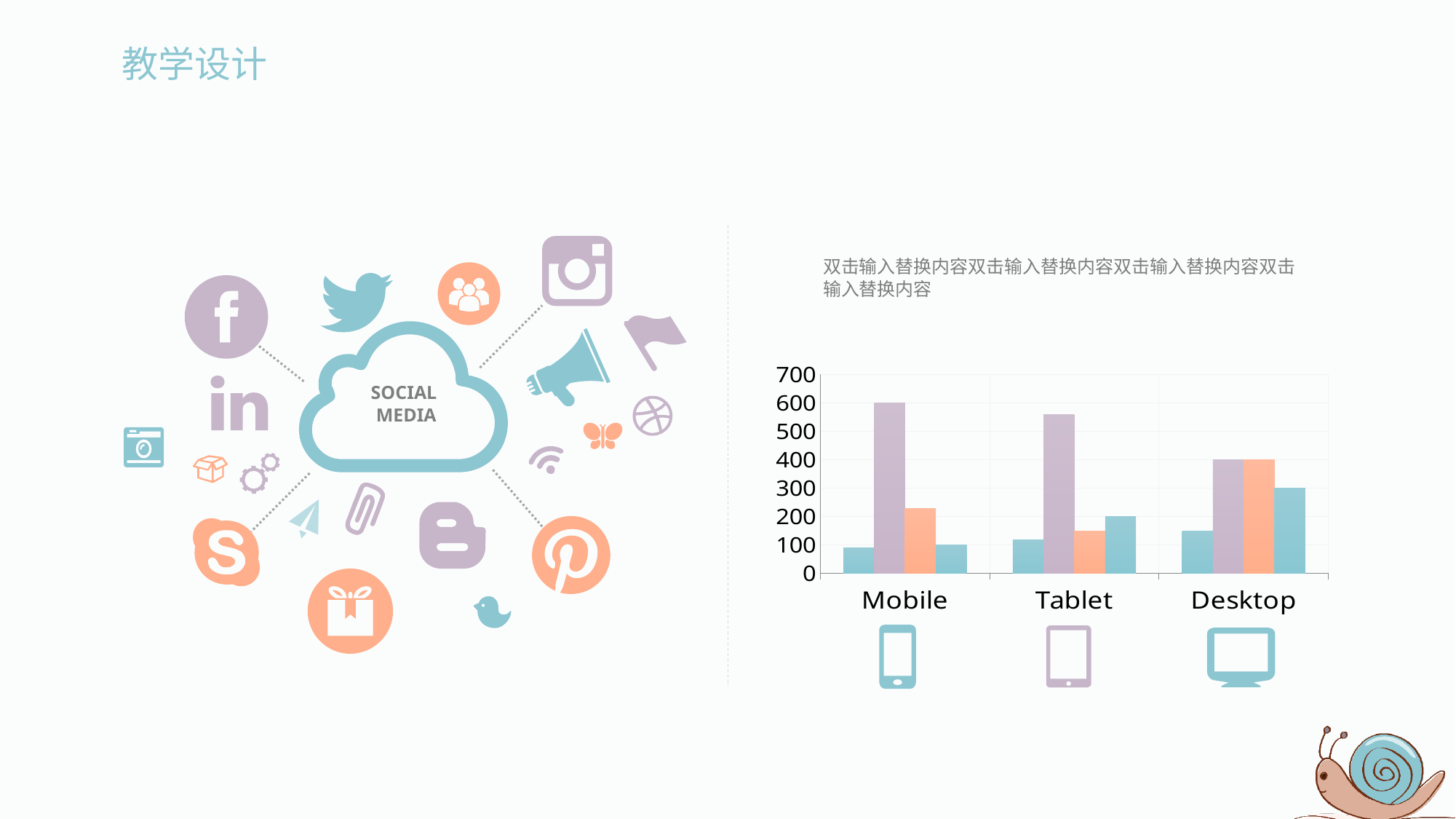
What is the value of the purple bar for Desktop? 400 What is the value of the rightmost (teal) bar for Tablet? 200 Which category has the tallest purple bar? Mobile What is the difference between the purple bar for Mobile and the purple bar for Desktop? 200 How many categories are shown on the x axis of the bar chart? 3 Is the value of the orange bar for Mobile greater or less than 300? less What is the value of the purple bar for Mobile? 600 What kind of chart is shown on the right side of the slide? bar chart Is the value of the purple bar for Tablet greater or less than 500? greater For Desktop, which is larger: the purple bar or the rightmost teal bar? the purple bar What is the value of the rightmost (teal) bar for Desktop? 300 What is the value of the orange bar for Desktop? 400